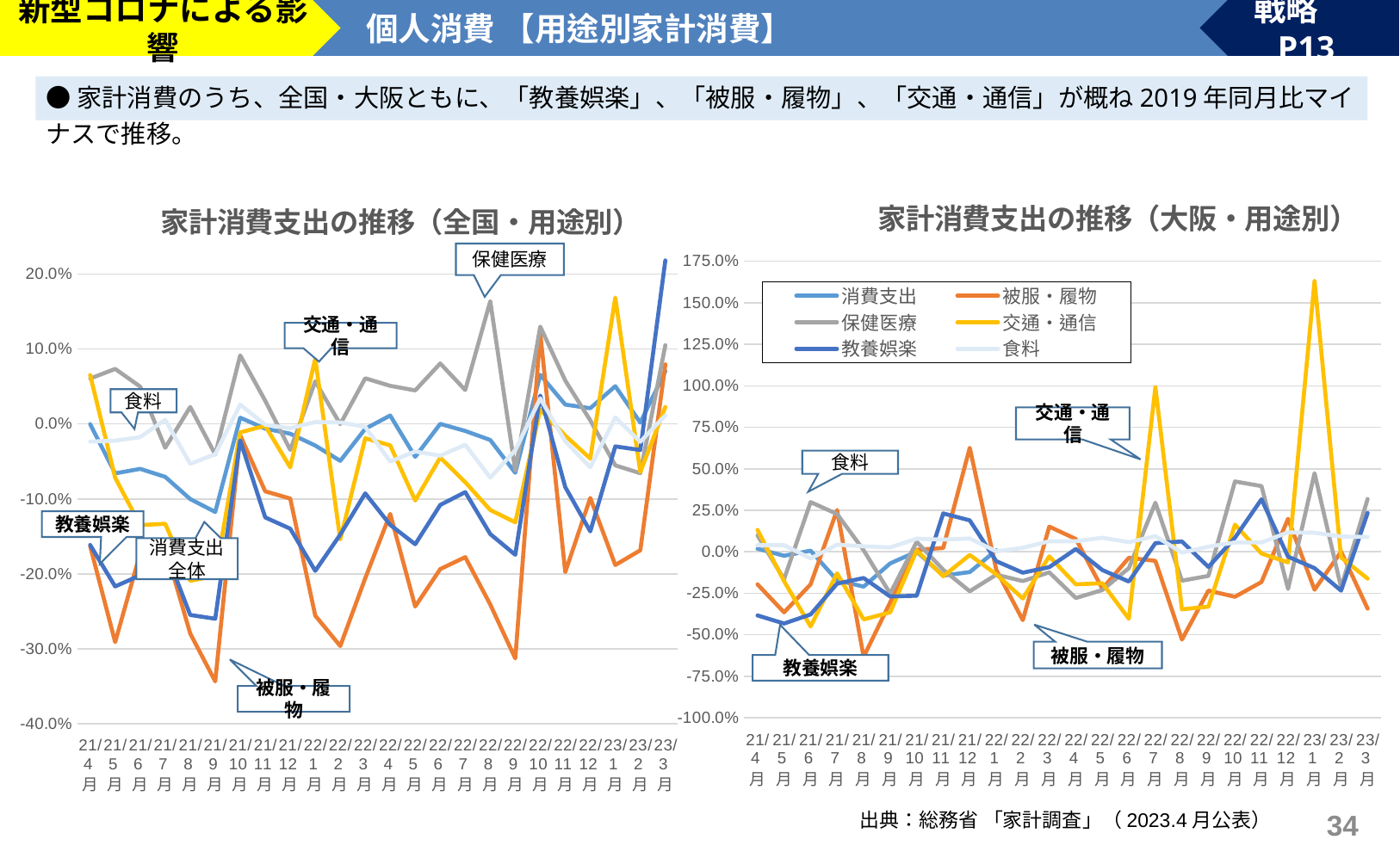
What kind of chart is the left chart titled 家計消費支出の推移（全国・用途別）? line chart In the right chart 家計消費支出の推移（大阪・用途別）, is the value for 交通・通信 in 23/1月 greater or less than 150.0%? greater What is the title of the left chart? 家計消費支出の推移（全国・用途別） In the left chart 家計消費支出の推移（全国・用途別）, which series reaches the lowest value on the chart? 被服・履物 In the left chart 家計消費支出の推移（全国・用途別）, is the value for 教養娯楽 in 23/3月 greater or less than 20.0%? greater In the right chart 家計消費支出の推移（大阪・用途別）, which series reaches the highest value on the chart? 交通・通信 How many monthly points are shown along the x axis of the right chart 家計消費支出の推移（大阪・用途別）? 24 In the right chart 家計消費支出の推移（大阪・用途別）, is the value for 被服・履物 in 21/12月 greater or less than 50.0%? greater What is the lowest value shown on the y axis of the right chart 家計消費支出の推移（大阪・用途別）? -100.0% How many series does the legend of the right chart 家計消費支出の推移（大阪・用途別） list? 6